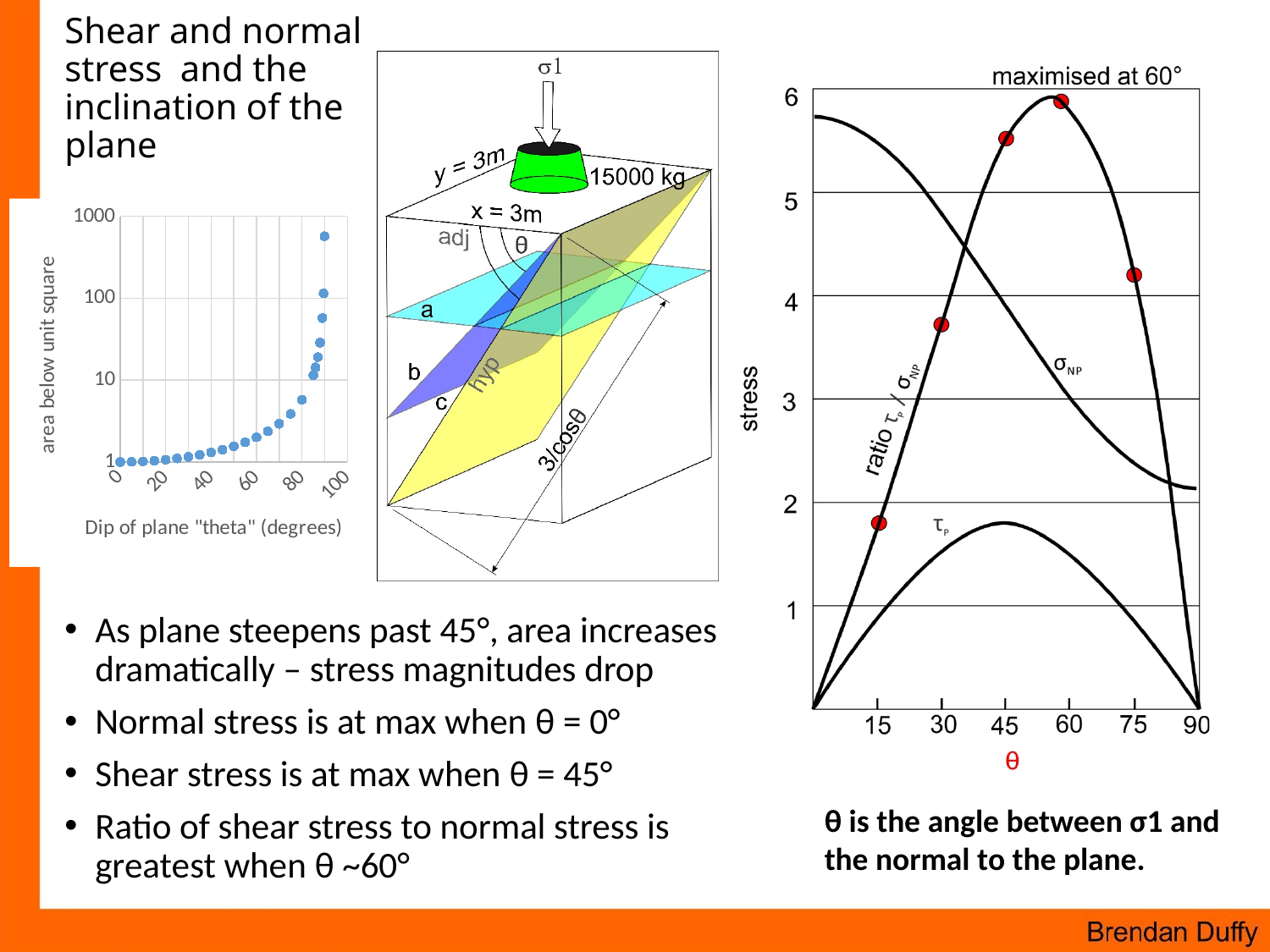
What kind of chart is the left-hand chart of area below unit square against dip of plane? scatter chart In the left-hand chart, what is the highest value shown on the y axis? 1000 In the right-hand stress chart, does the σNP curve rise or fall as θ increases? fall In the left-hand chart, is the highest plotted value greater or less than 100? greater In the left-hand chart, what is the label of the x axis? Dip of plane "theta" (degrees) In the right-hand stress chart, is the peak value of the τP curve greater or less than 2? less In the left-hand chart, do the plotted values rise or fall as the dip of the plane increases? rise In the right-hand stress chart, is the value of σNP at θ = 0 greater or less than 5? greater In the right-hand stress chart, which is larger at θ = 75: σNP or τP? σNP In the right-hand stress chart, how many curves are plotted? 3 In the right-hand stress chart, at what value of θ is the ratio τP/σNP curve maximised? 60°